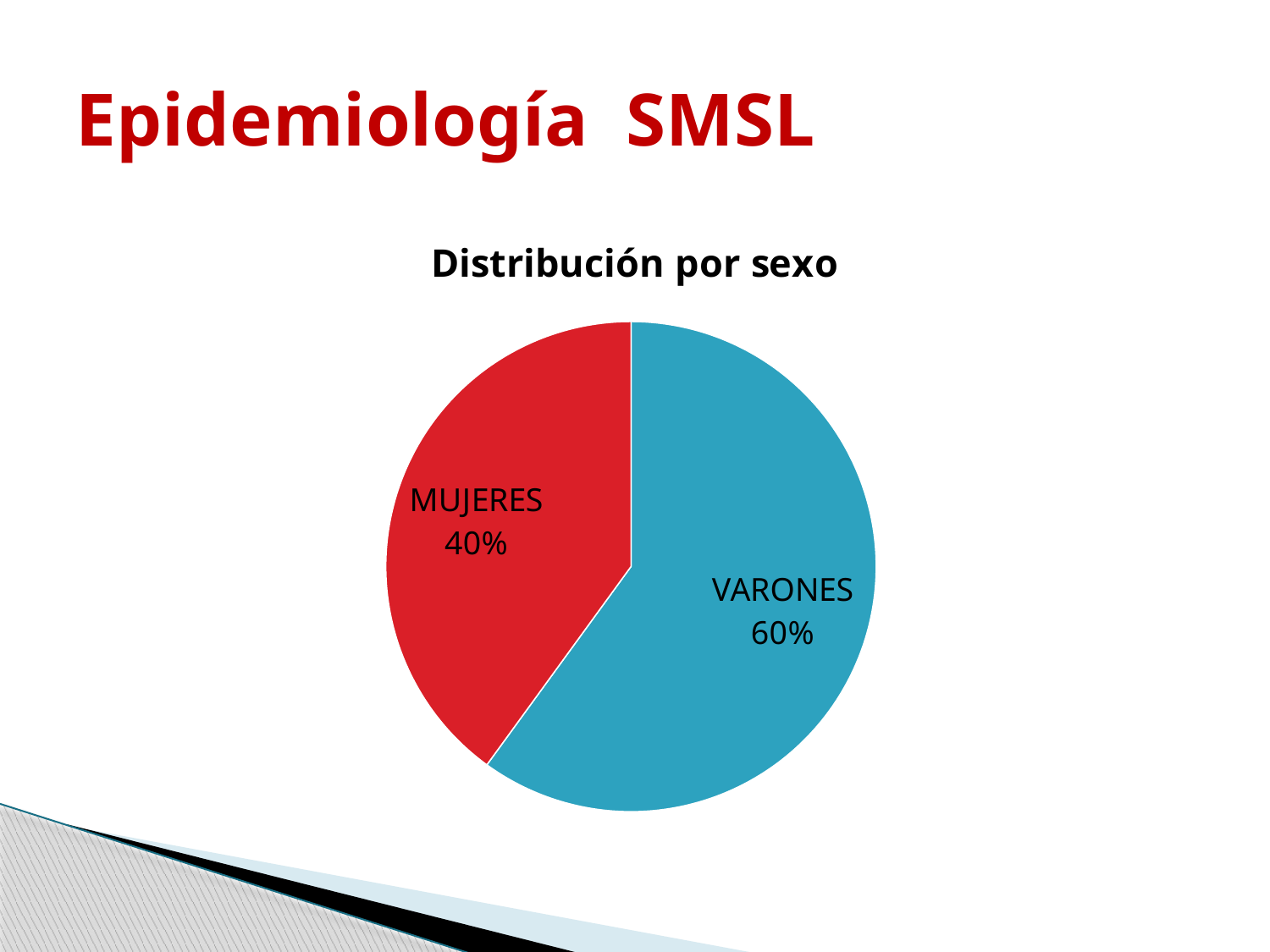
Which slice is the smallest in the pie chart? MUJERES What share of the pie does the MUJERES slice represent? 40% Which slice is the largest in the pie chart? VARONES What kind of chart is shown on the slide? pie chart What percentage of the pie is VARONES? 60% What colour is the VARONES slice? blue What is the difference in percentage points between VARONES and MUJERES? 20 percentage points What percentage of the pie is MUJERES? 40% How many slices does the pie chart have? 2 What is the title of the chart? Distribución por sexo Which is larger, the VARONES slice or the MUJERES slice? VARONES